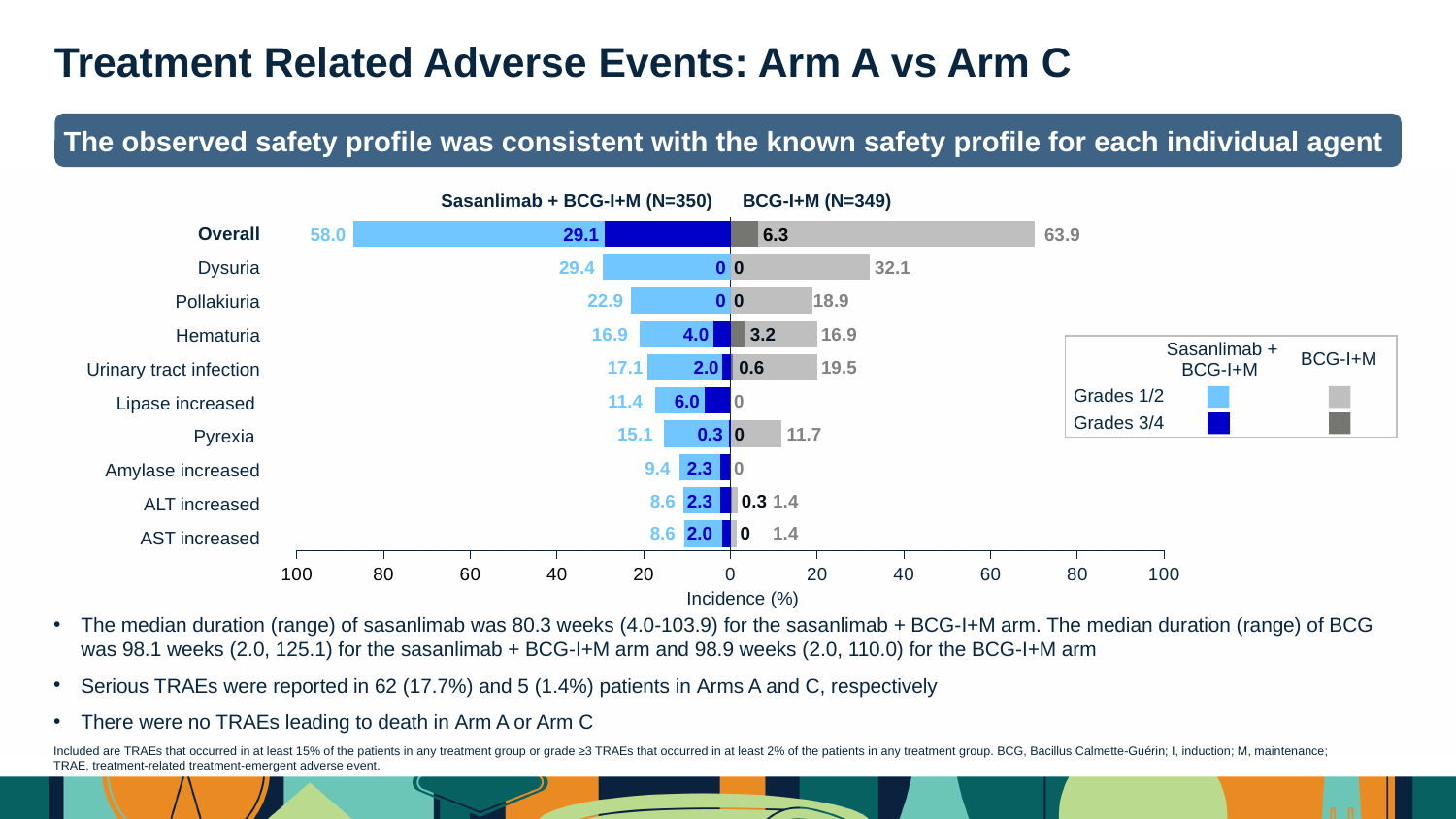
How many entries does the legend list? 4 How many adverse event categories are listed on the chart? 10 What is the Grades 1/2 incidence of Dysuria in the Sasanlimab + BCG-I+M arm? 29.4 What is the difference between the Overall Grades 1/2 incidence in the BCG-I+M arm and in the Sasanlimab + BCG-I+M arm? 5.9 For Dysuria, which arm has the larger Grades 1/2 incidence, Sasanlimab + BCG-I+M or BCG-I+M? BCG-I+M What is the total Overall incidence (Grades 1/2 plus Grades 3/4) for the Sasanlimab + BCG-I+M arm? 87.1 What kind of chart is shown on the slide? Bar chart Which adverse event category has the highest Grades 1/2 incidence in the BCG-I+M arm? Overall What is the label of the horizontal axis of the chart? Incidence (%) What is the Grades 3/4 incidence of Lipase increased in the Sasanlimab + BCG-I+M arm? 6.0 What is the Grades 1/2 incidence of Pyrexia in the BCG-I+M arm? 11.7 What is the Grades 3/4 incidence of Hematuria in the BCG-I+M arm? 3.2